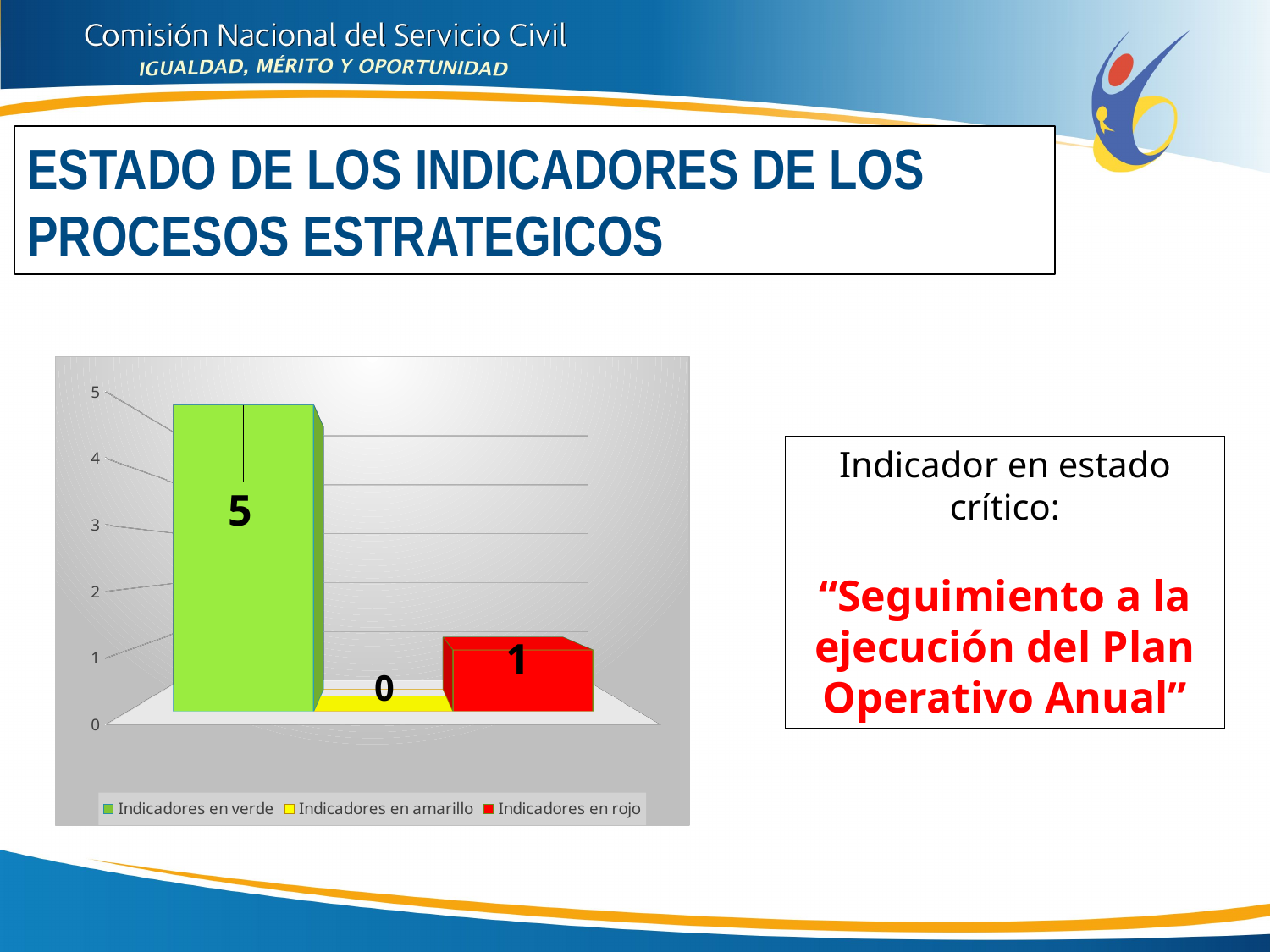
Which series has the lowest value? Indicadores en amarillo Which is larger, the value for Indicadores en rojo or Indicadores en amarillo? Indicadores en rojo What is the value for Indicadores en rojo? 1 What is the value for Indicadores en amarillo? 0 How many series does the legend list? 3 What kind of chart is shown on the slide? bar chart Which series has the highest value? Indicadores en verde What is the value for Indicadores en verde? 5 What colour is the bar for Indicadores en rojo? red What is the difference between the values for Indicadores en verde and Indicadores en rojo? 4 Is the value for Indicadores en verde greater or less than 3? greater What is the total of the three values shown in the chart? 6